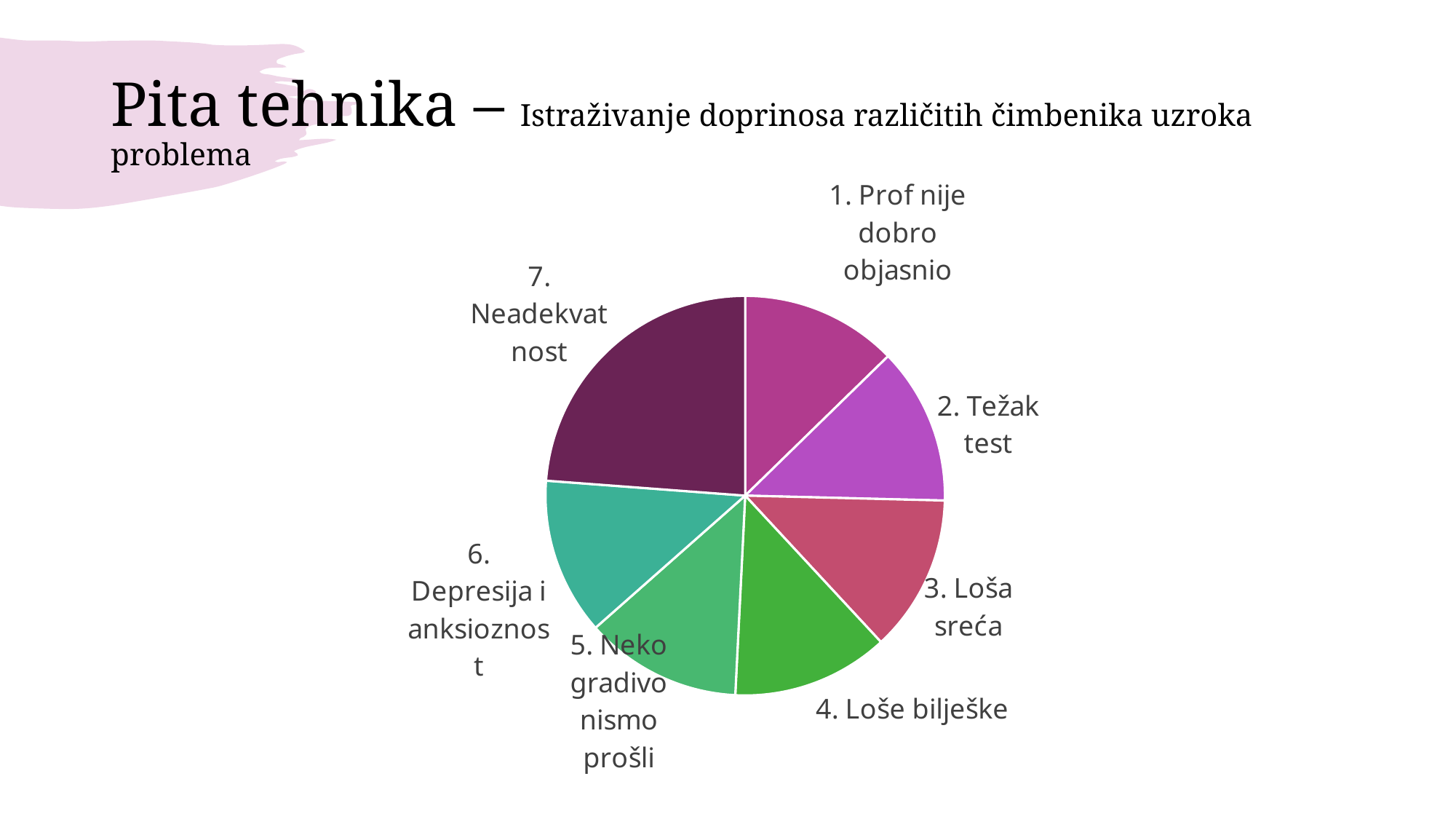
Which slice is larger: "7. Neadekvatnost" or "4. Loše bilješke"? 7. Neadekvatnost What is the label of the slice numbered 6 in the pie chart? 6. Depresija i anksioznost What kind of chart is shown on the slide? pie chart Which slice is larger: "2. Težak test" or "7. Neadekvatnost"? 7. Neadekvatnost How many slices does the pie chart have? 7 What is the label of the slice numbered 4 in the pie chart? 4. Loše bilješke Which slice is larger: "7. Neadekvatnost" or "1. Prof nije dobro objasnio"? 7. Neadekvatnost Which category has the largest slice of the pie chart? 7. Neadekvatnost